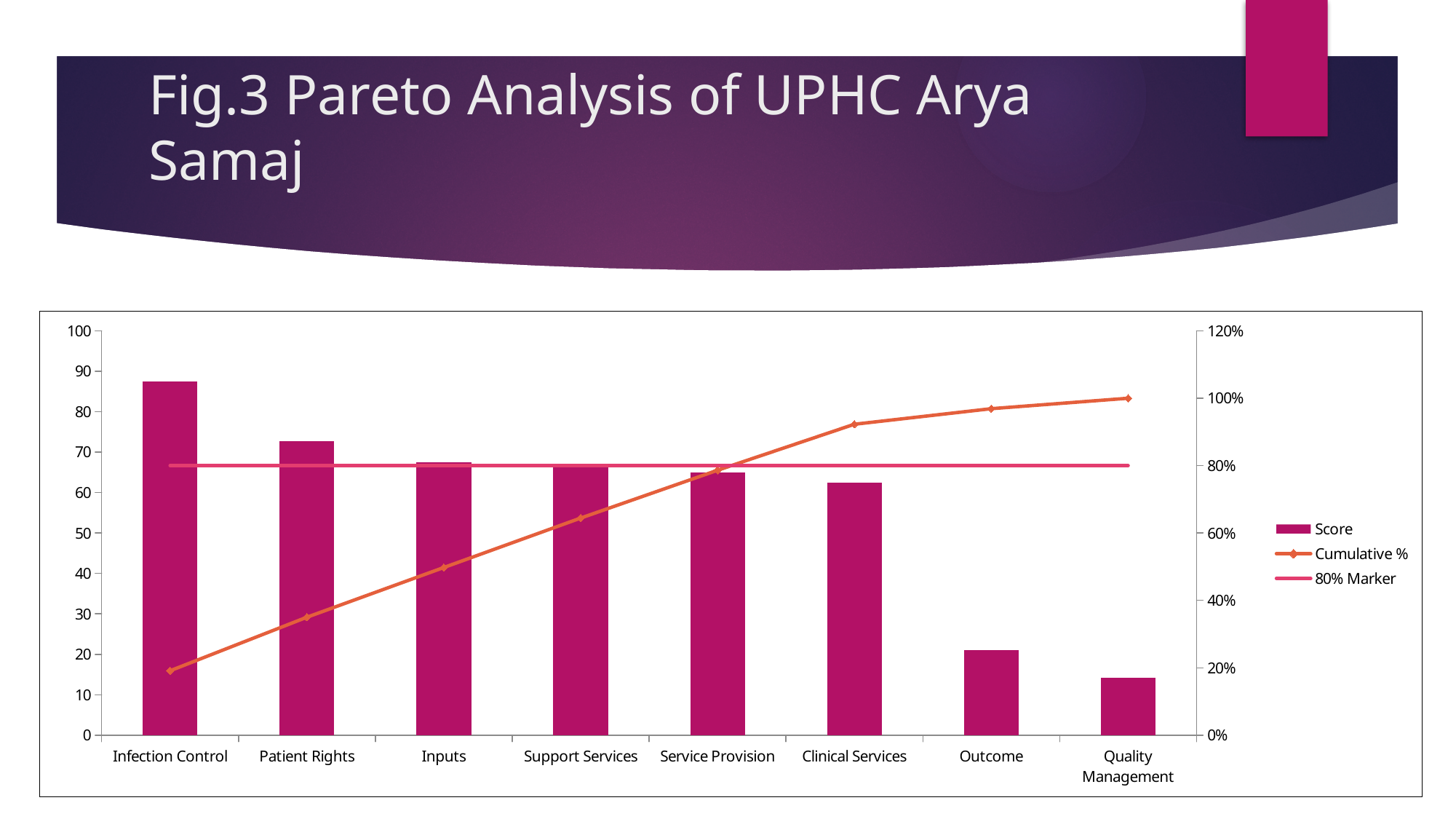
How many series does the legend list? 3 How many categories are shown along the x axis? 8 Is the Score for Outcome greater or less than 30? less What is the title of the slide containing the chart? Fig.3 Pareto Analysis of UPHC Arya Samaj Which category has the highest Score? Infection Control Does the Cumulative % line rise or fall from Infection Control to Quality Management? Rises Which has a higher Score, Outcome or Quality Management? Outcome Is the Score for Infection Control greater or less than 80? greater Is the Score for Quality Management greater or less than 20? less Which category has the lowest Score? Quality Management What kind of chart is shown on the slide? Combined bar and line chart At what level on the right-hand axis is the 80% Marker line drawn? 80%